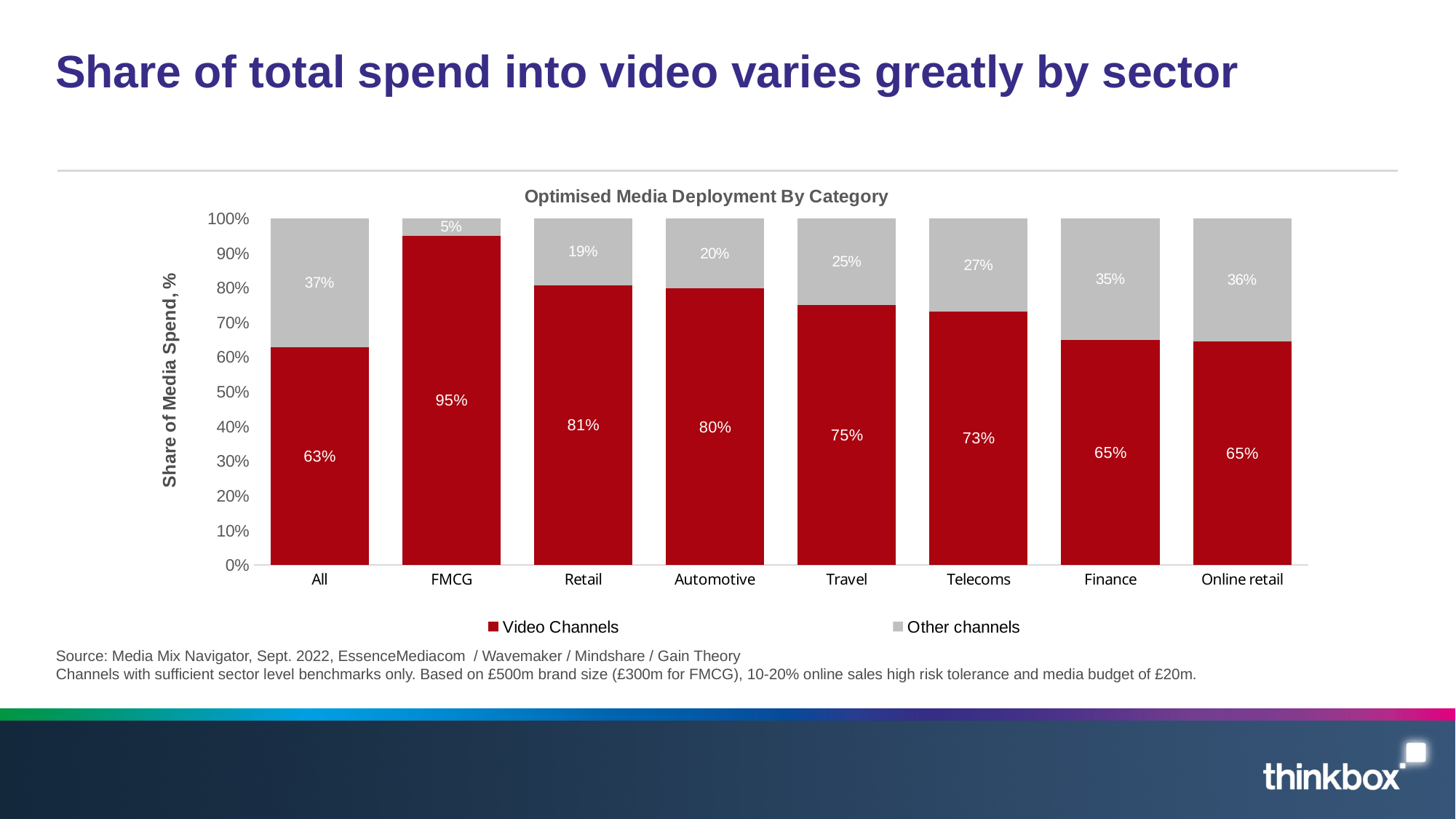
What is the difference between the Video Channels share for Retail and for Travel? 6% Which category has the highest Video Channels share? FMCG Which has a larger Other channels share, Finance or Automotive? Finance How many series does the legend list? 2 What is the Video Channels share for FMCG? 95% What is the Other channels share for Telecoms? 27% How many categories are shown on the x axis? 8 What is the Video Channels share for Automotive? 80% What kind of chart is shown on the slide? Stacked bar chart Which category has the lowest Video Channels share? All What is the title of the chart? Optimised Media Deployment By Category